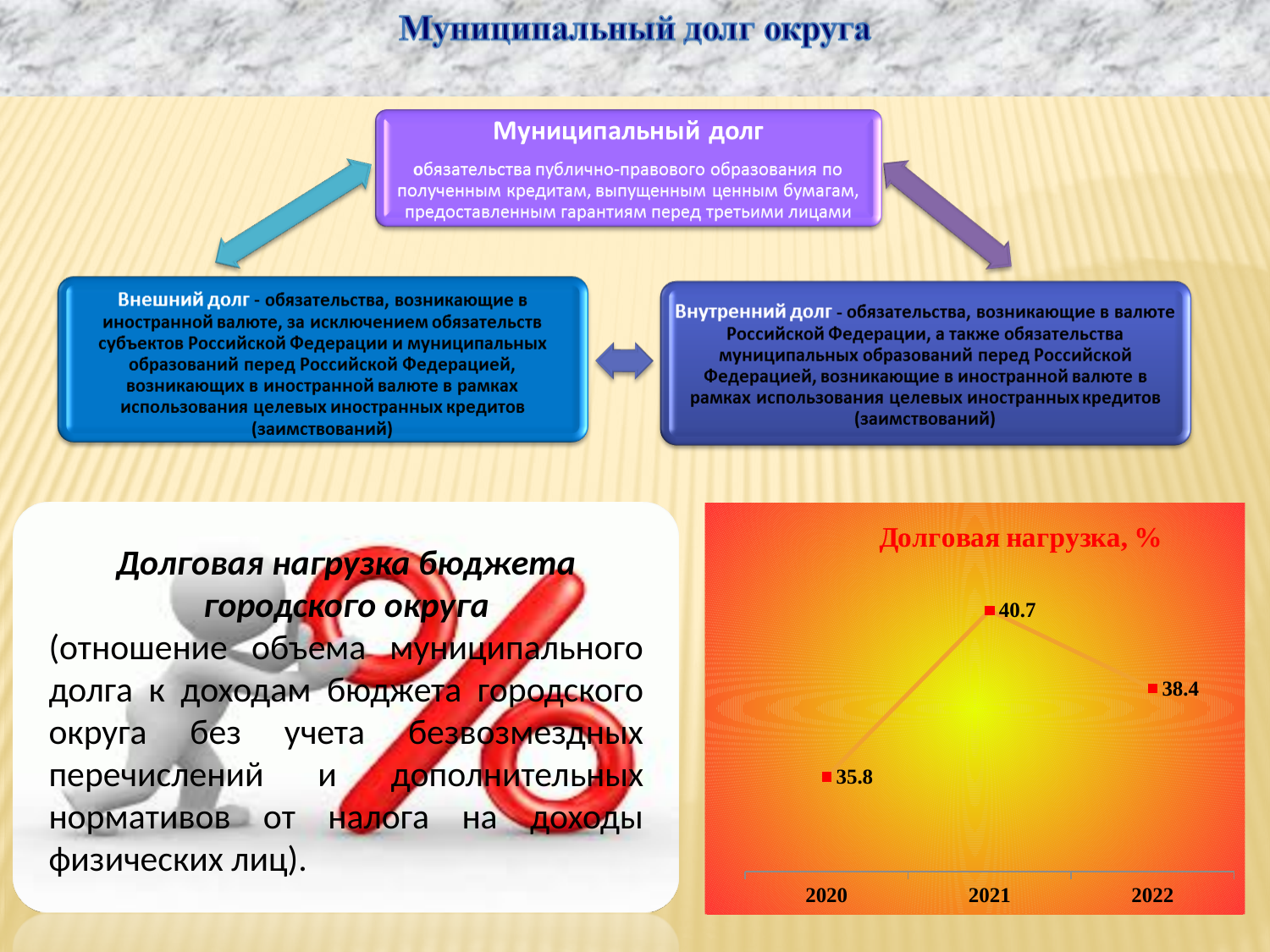
What is the value for 2021 in the 'Долговая нагрузка, %' chart? 40.7 In the 'Долговая нагрузка, %' chart, is the value for 2022 larger or smaller than the value for 2020? larger What is the value for 2020 in the 'Долговая нагрузка, %' chart? 35.8 What is the title of the chart on the slide? Долговая нагрузка, % What is the difference between the 2021 and 2022 values in the 'Долговая нагрузка, %' chart? 2.3 In the 'Долговая нагрузка, %' chart, does the value rise or fall from 2021 to 2022? fall What is the value for 2022 in the 'Долговая нагрузка, %' chart? 38.4 What is the difference between the 2021 and 2020 values in the 'Долговая нагрузка, %' chart? 4.9 What kind of chart is the 'Долговая нагрузка, %' chart? line chart Which year has the highest value in the 'Долговая нагрузка, %' chart? 2021 How many years are plotted in the 'Долговая нагрузка, %' chart? 3 Which year has the lowest value in the 'Долговая нагрузка, %' chart? 2020